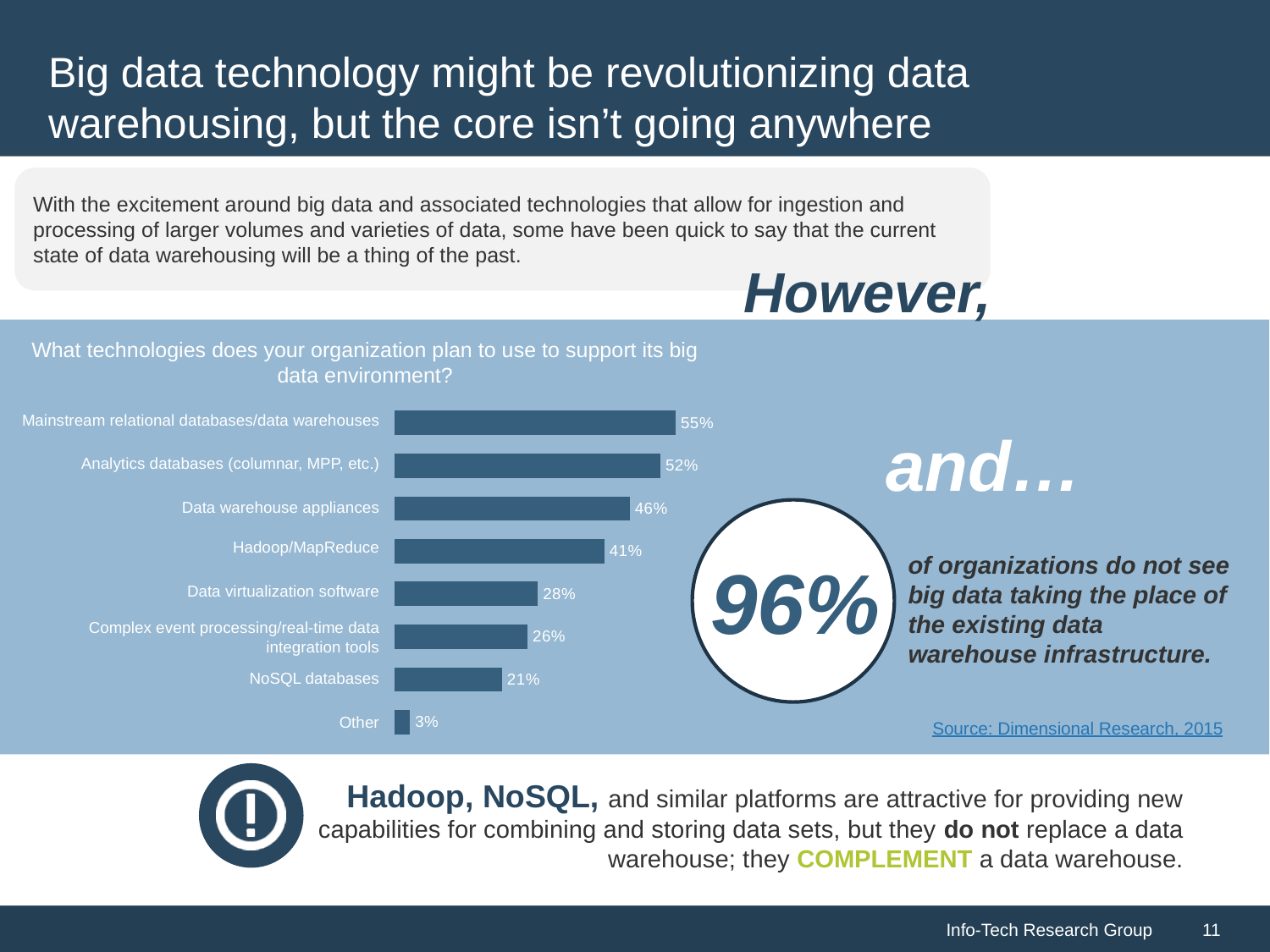
What is the value shown for Hadoop/MapReduce in the bar chart? 41% What is the value shown for NoSQL databases in the bar chart? 21% Which has a larger value: Data virtualization software or Complex event processing/real-time data integration tools? Data virtualization software What is the difference between the values for Analytics databases (columnar, MPP, etc.) and Data warehouse appliances? 6% How many categories are shown in the bar chart? 8 What percentage of organizations plan to use Mainstream relational databases/data warehouses to support their big data environment? 55% What is the difference between the values for Hadoop/MapReduce and NoSQL databases? 20% Which category has the lowest value in the bar chart? Other Which category has the highest value in the bar chart? Mainstream relational databases/data warehouses What type of chart is used to show the technologies organizations plan to use for their big data environment? Bar chart What is the title of the bar chart on the slide? What technologies does your organization plan to use to support its big data environment? Do the values in the bar chart increase or decrease from the top category to the bottom category? Decrease